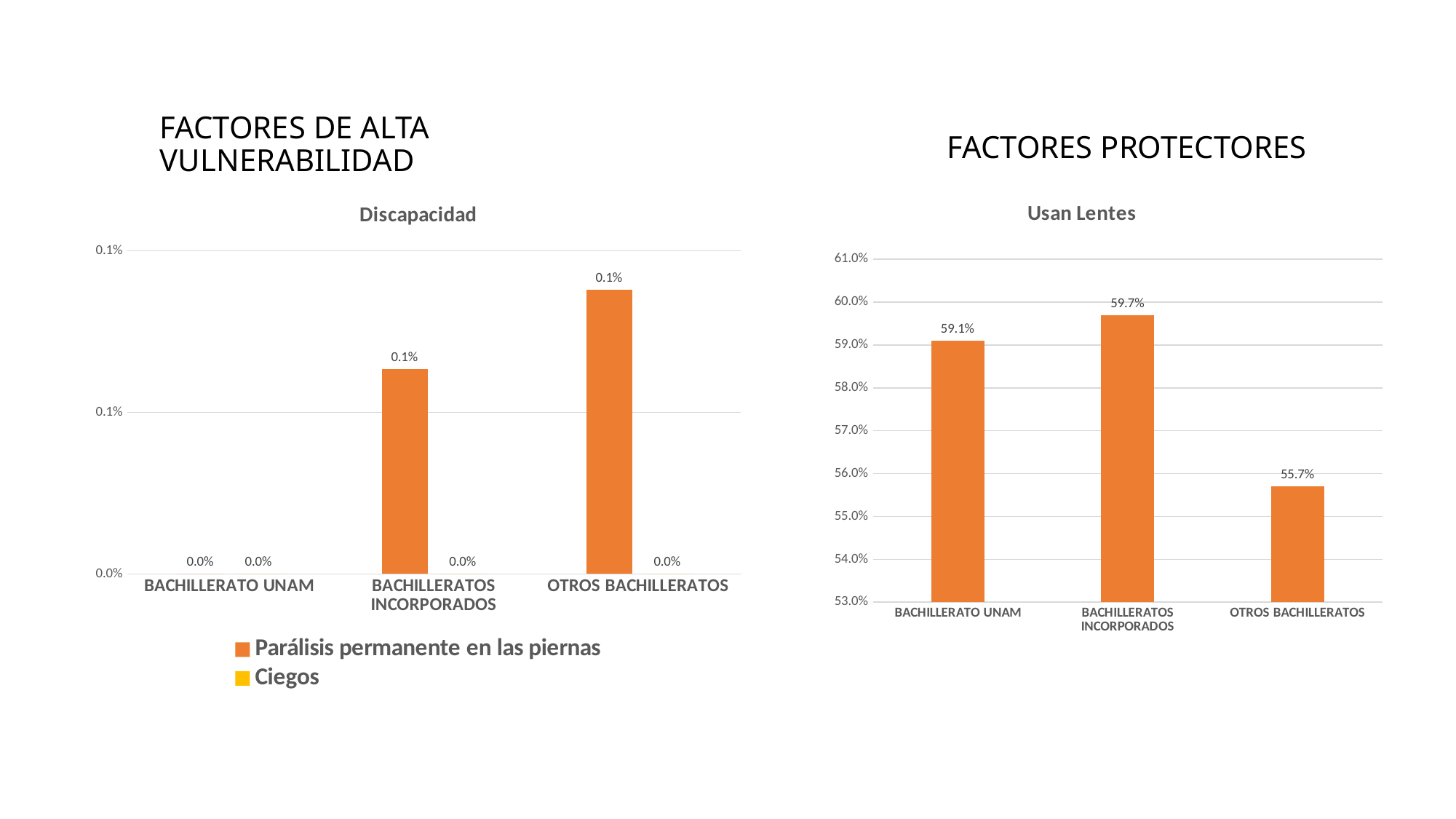
In the 'Usan Lentes' chart, what is the value for OTROS BACHILLERATOS? 55.7% In the 'Discapacidad' chart, what is the value of 'Ciegos' for OTROS BACHILLERATOS? 0.0% What kind of chart is the 'Usan Lentes' chart? bar chart In the 'Usan Lentes' chart, how many categories are shown on the x axis? 3 In the 'Usan Lentes' chart, what is the value for BACHILLERATO UNAM? 59.1% In the 'Usan Lentes' chart, what is the difference between the values for BACHILLERATOS INCORPORADOS and OTROS BACHILLERATOS? 4.0% In the 'Usan Lentes' chart, is the value for OTROS BACHILLERATOS greater or less than 57.0%? less In the 'Discapacidad' chart, which series is shown in orange? Parálisis permanente en las piernas In the 'Discapacidad' chart, how many series does the legend list? 2 In the 'Usan Lentes' chart, which category has the highest value? BACHILLERATOS INCORPORADOS In the 'Usan Lentes' chart, which category has the lowest value? OTROS BACHILLERATOS In the 'Discapacidad' chart, what is the value of 'Parálisis permanente en las piernas' for BACHILLERATOS INCORPORADOS? 0.1%